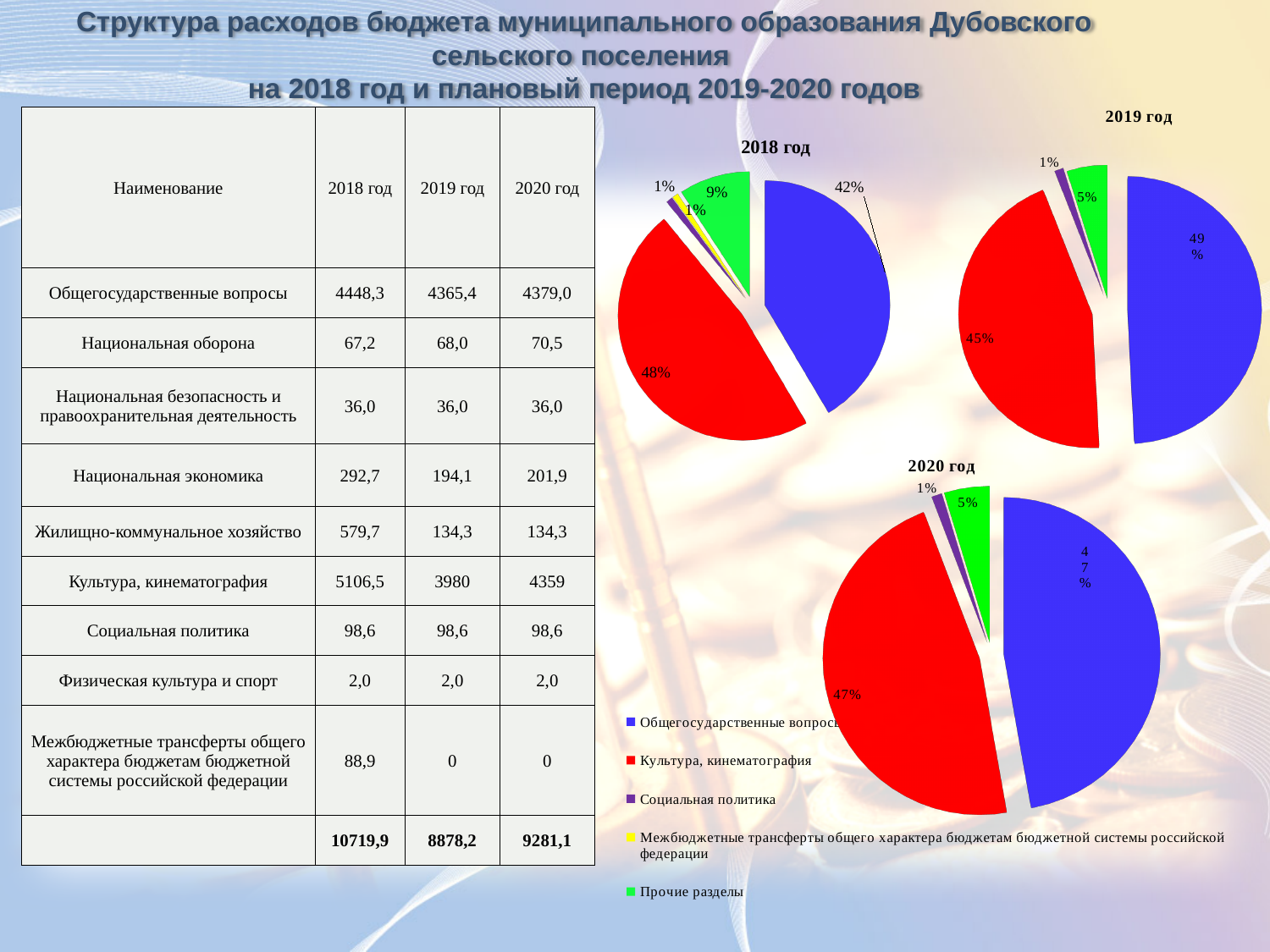
In the 2018 год pie chart, which category has the largest share? Культура, кинематография In the 2019 год pie chart, what share does Культура, кинематография have? 45% In the 2018 год pie chart, what is the difference between the shares of Культура, кинематография and Общегосударственные вопросы? 6% In the 2019 год pie chart, what share does Общегосударственные вопросы have? 49% In the 2019 год pie chart, which category has the largest share? Общегосударственные вопросы In the 2018 год pie chart, what share does Культура, кинематография have? 48% What type of charts are shown on the slide? Pie charts How many categories does the legend of the pie charts list? 5 In the 2019 год pie chart, which is larger: the share of Общегосударственные вопросы or the share of Культура, кинематография? Общегосударственные вопросы In the 2018 год pie chart, what share does Общегосударственные вопросы have? 42% In the 2018 год pie chart, what share does Прочие разделы have? 9% In the 2020 год pie chart, what share does Прочие разделы have? 5%